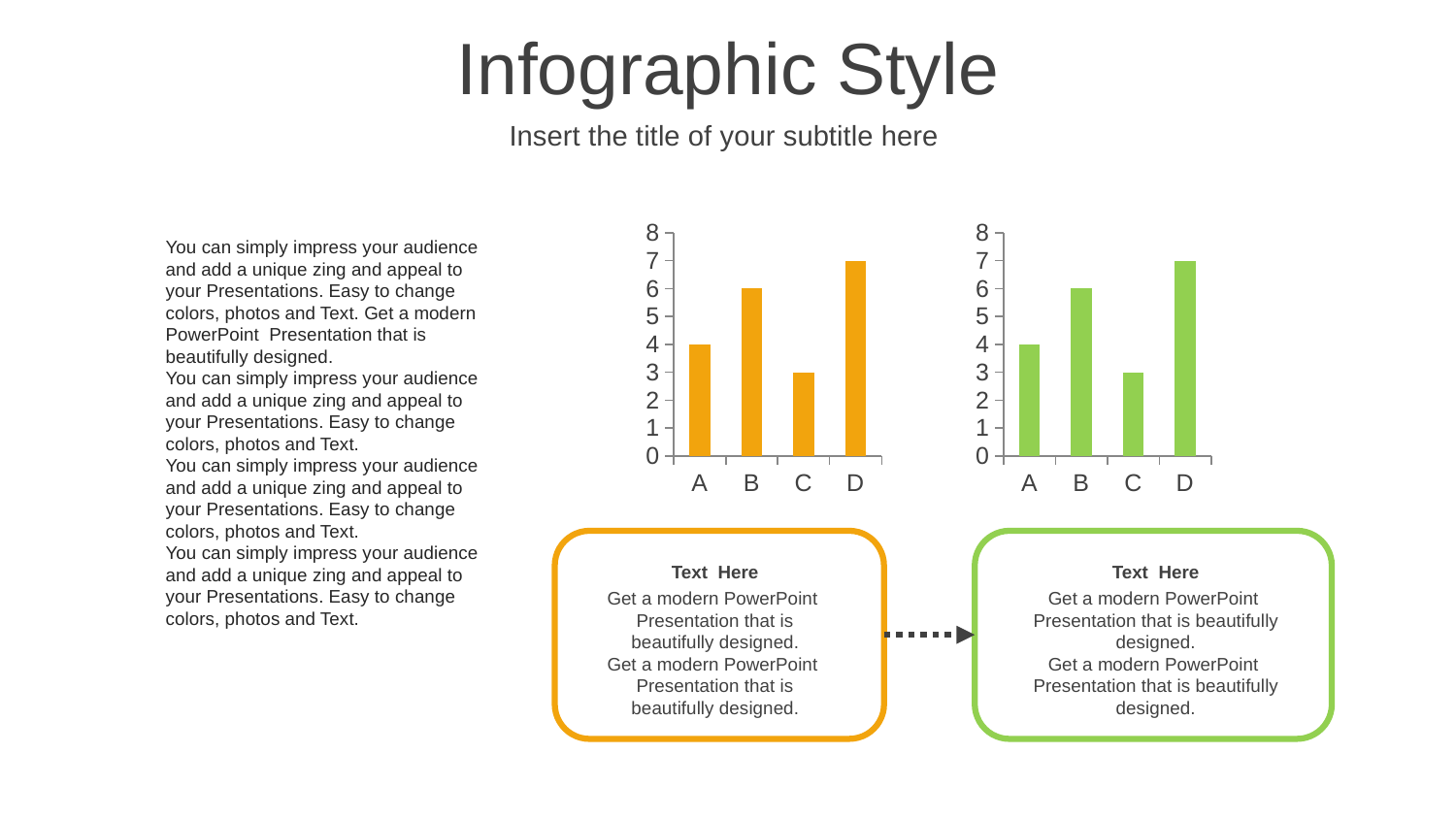
What colour are the bars in the right chart? green What is the maximum value shown on the y axis of the left (orange) chart? 8 In the right (green) chart, which is larger, the value for A or the value for B? B In the left (orange) chart, what is the value for category D? 7 In the right (green) chart, what is the value for category B? 6 In the left (orange) chart, which category has the highest value? D In the right (green) chart, what is the value for category A? 4 In the left (orange) chart, what is the difference between the values for B and C? 3 In the right (green) chart, which category has the lowest value? C How many categories are shown on the x axis of the right (green) chart? 4 In the left (orange) chart, is the value for C greater or less than 4? less What kind of chart is the left (orange) chart? bar chart